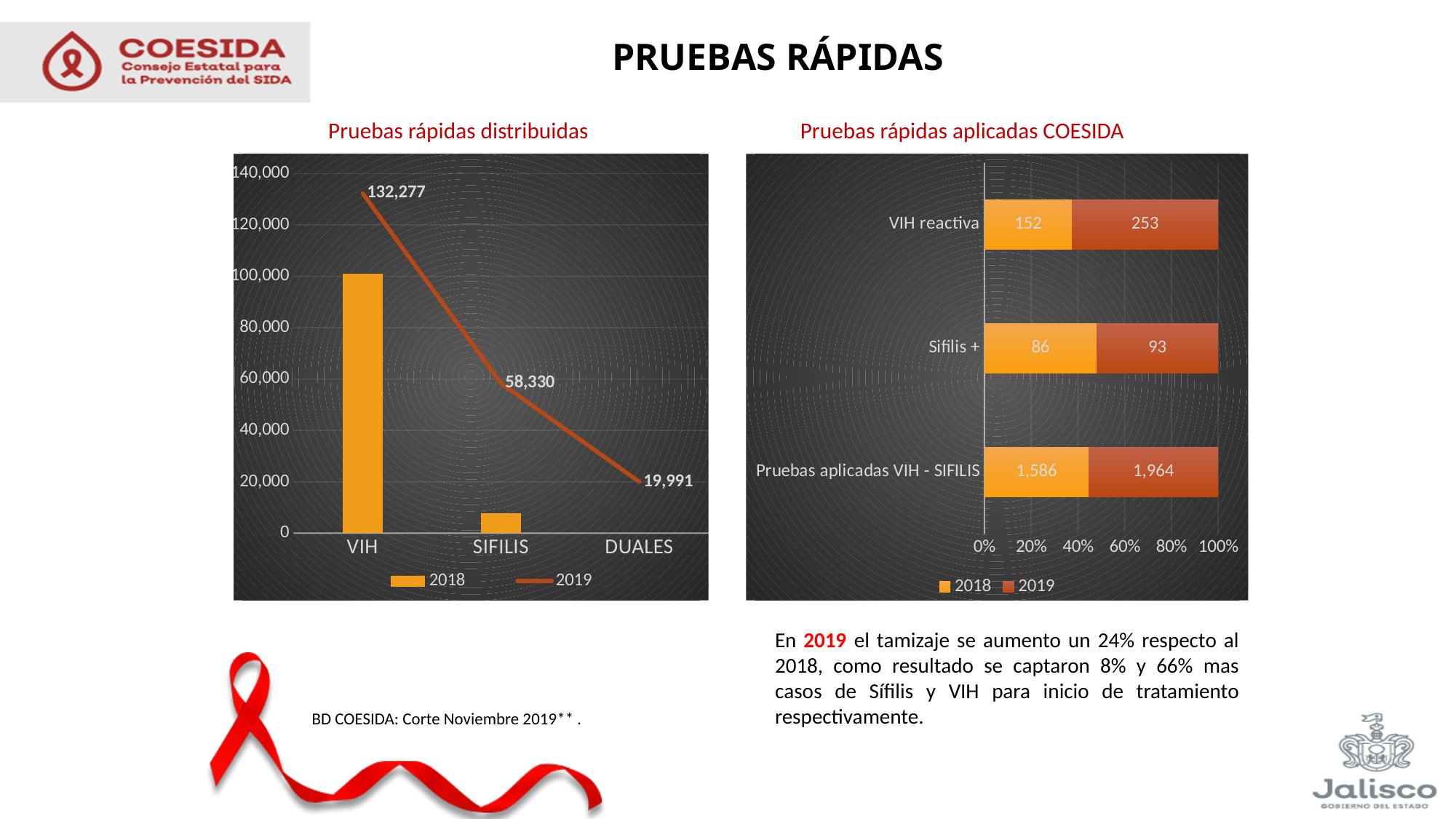
In the 'Pruebas rápidas aplicadas COESIDA' chart, what is the 2018 value for Sifilis +? 86 In the 'Pruebas rápidas distribuidas' chart, is the 2018 value for SIFILIS greater or less than 20,000? less In the 'Pruebas rápidas distribuidas' chart, which category has the highest 2019 value? VIH In the 'Pruebas rápidas aplicadas COESIDA' chart, how many series does the legend list? 2 In the 'Pruebas rápidas distribuidas' chart, what is the 2019 value for SIFILIS? 58,330 In the 'Pruebas rápidas distribuidas' chart, do the 2019 values rise or fall from VIH to DUALES? fall In the 'Pruebas rápidas distribuidas' chart, is the 2018 value for VIH greater or less than 80,000? greater In the 'Pruebas rápidas distribuidas' chart, what is the 2019 value for VIH? 132,277 In the 'Pruebas rápidas distribuidas' chart, what is the difference between the 2019 values for VIH and SIFILIS? 73,947 In the 'Pruebas rápidas aplicadas COESIDA' chart, what is the total of the 2018 and 2019 values for Pruebas aplicadas VIH - SIFILIS? 3,550 In the 'Pruebas rápidas aplicadas COESIDA' chart, what is the 2019 value for VIH reactiva? 253 In the 'Pruebas rápidas distribuidas' chart, what is the 2019 value for DUALES? 19,991